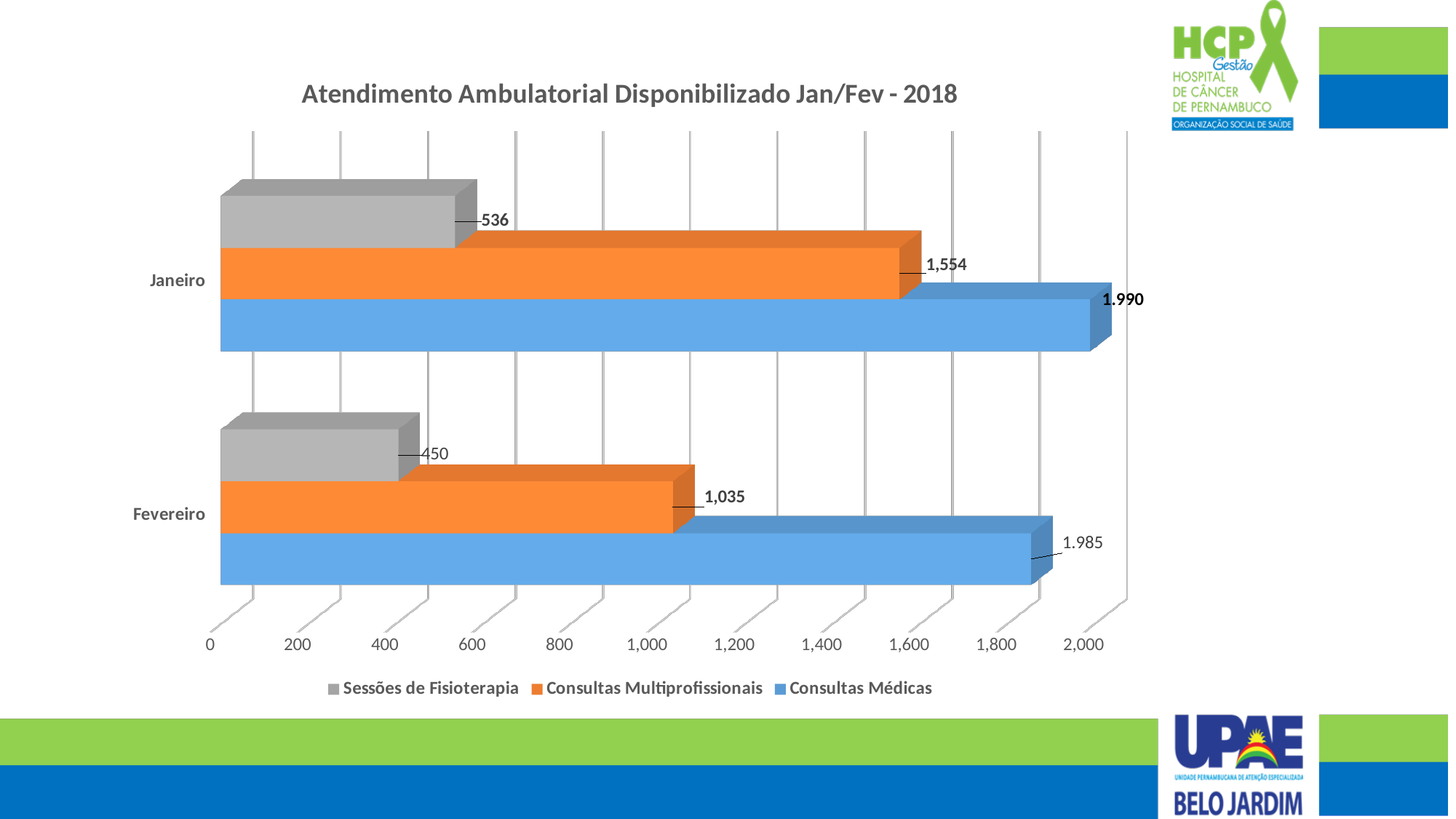
What is the value of Sessões de Fisioterapia for Fevereiro? 450 How many series does the legend list? 3 What kind of chart is shown on the slide? Bar chart What is the difference between Consultas Multiprofissionais in Janeiro and in Fevereiro? 519 What is the value of Consultas Médicas for Janeiro? 1.990 What is the value of Sessões de Fisioterapia for Janeiro? 536 Which is larger: Consultas Multiprofissionais in Janeiro or in Fevereiro? Janeiro What is the difference between Sessões de Fisioterapia in Janeiro and in Fevereiro? 86 What is the title of the chart? Atendimento Ambulatorial Disponibilizado Jan/Fev - 2018 Which series has the highest value for Fevereiro? Consultas Médicas Which series has the lowest value for Janeiro? Sessões de Fisioterapia What is the value of Consultas Multiprofissionais for Fevereiro? 1,035